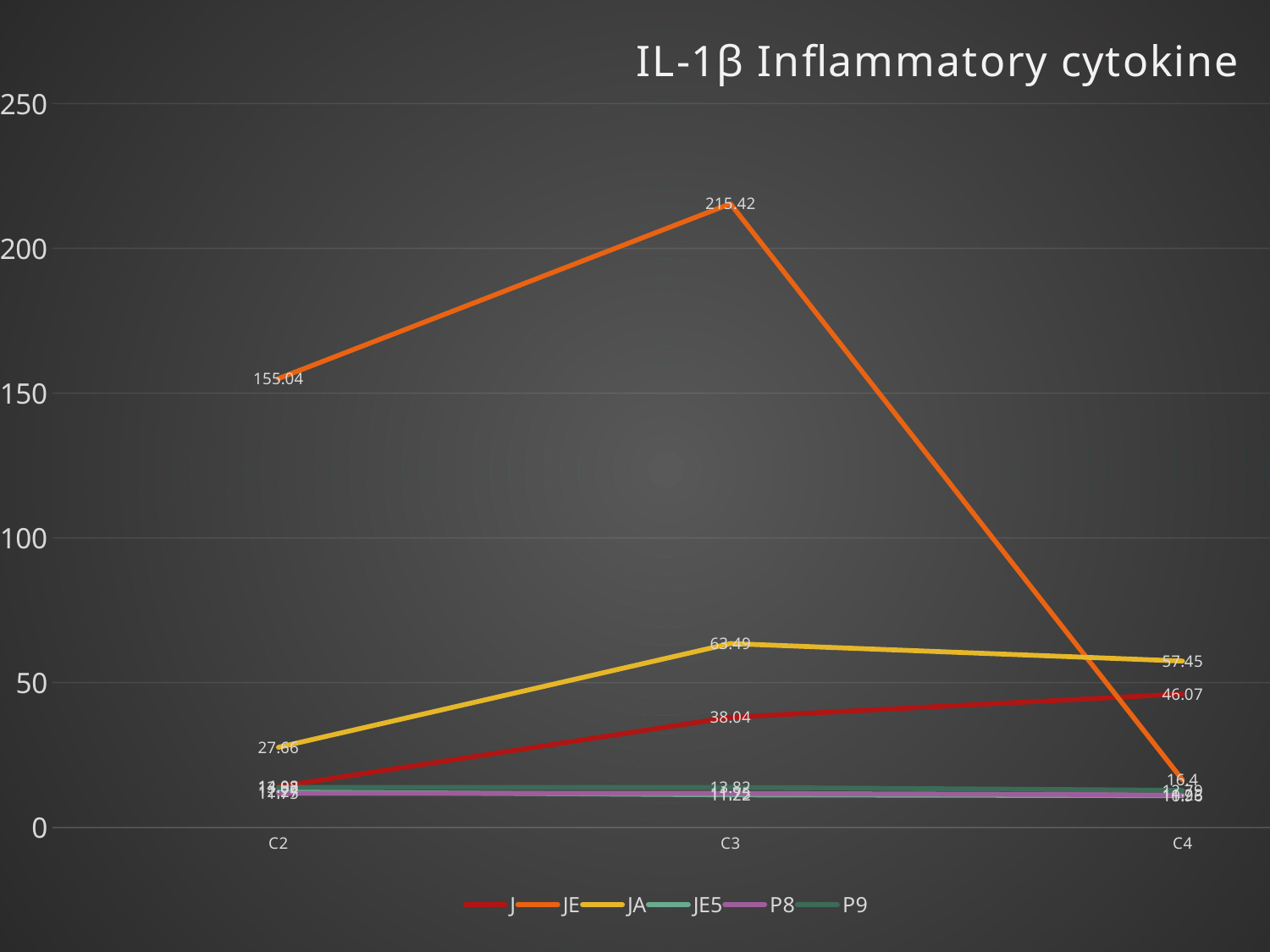
At C4, which series has the larger value, JA or J? JA At which category does the JE series reach its highest value? C3 What is the value of the J series at C4? 46.07 What is the title of the chart? IL-1β Inflammatory cytokine What is the value of the JE series at C2? 155.04 What is the value of the JE series at C3? 215.42 How many categories are shown on the x axis? 3 Does the J series rise or fall from C2 to C4? Rises What is the difference between the JE values at C3 and C2? 60.38 How many series does the legend list? 6 What kind of chart is shown on the slide? Line chart What is the value of the JA series at C3? 63.49